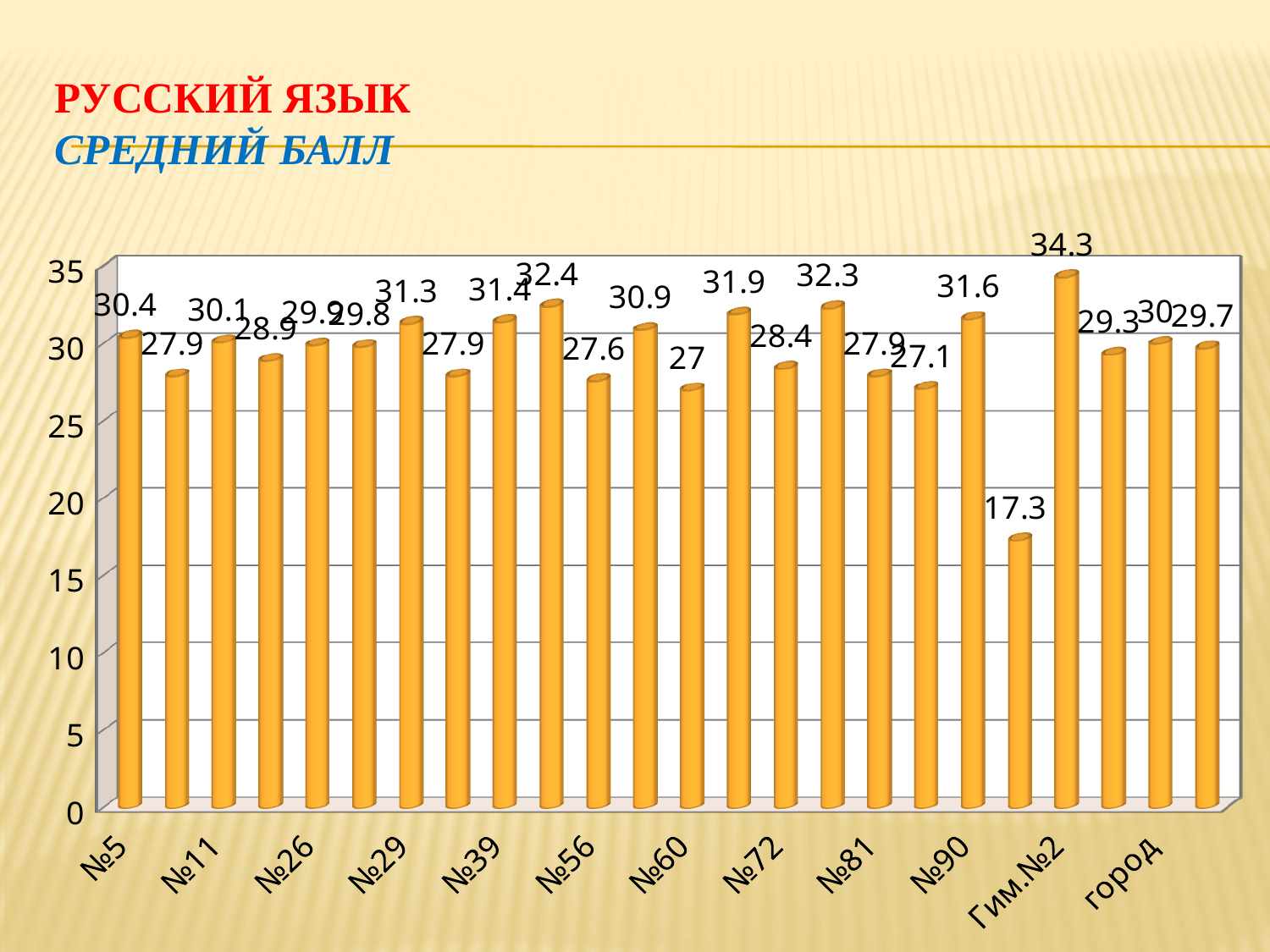
How many bars are plotted on the chart? 24 Which is larger: the first bar (30.4) or the second bar (27.9)? the first bar (30.4) Is the tallest bar on the chart (34.3) greater or less than 30? greater Is the lowest bar on the chart (17.3) greater or less than 20? less What type of chart is shown on the slide? bar chart What is the lowest value shown on the chart? 17.3 What is the value of the tallest bar, labelled Гим.№2? 34.3 What is the difference between the highest value (34.3) and the lowest value (17.3) on the chart? 17 What is the maximum value shown on the vertical axis? 35 What is the highest value shown on the chart? 34.3 What is the subtitle of the chart shown in blue italics? СРЕДНИЙ БАЛЛ What is the value of the first bar on the chart (№5)? 30.4